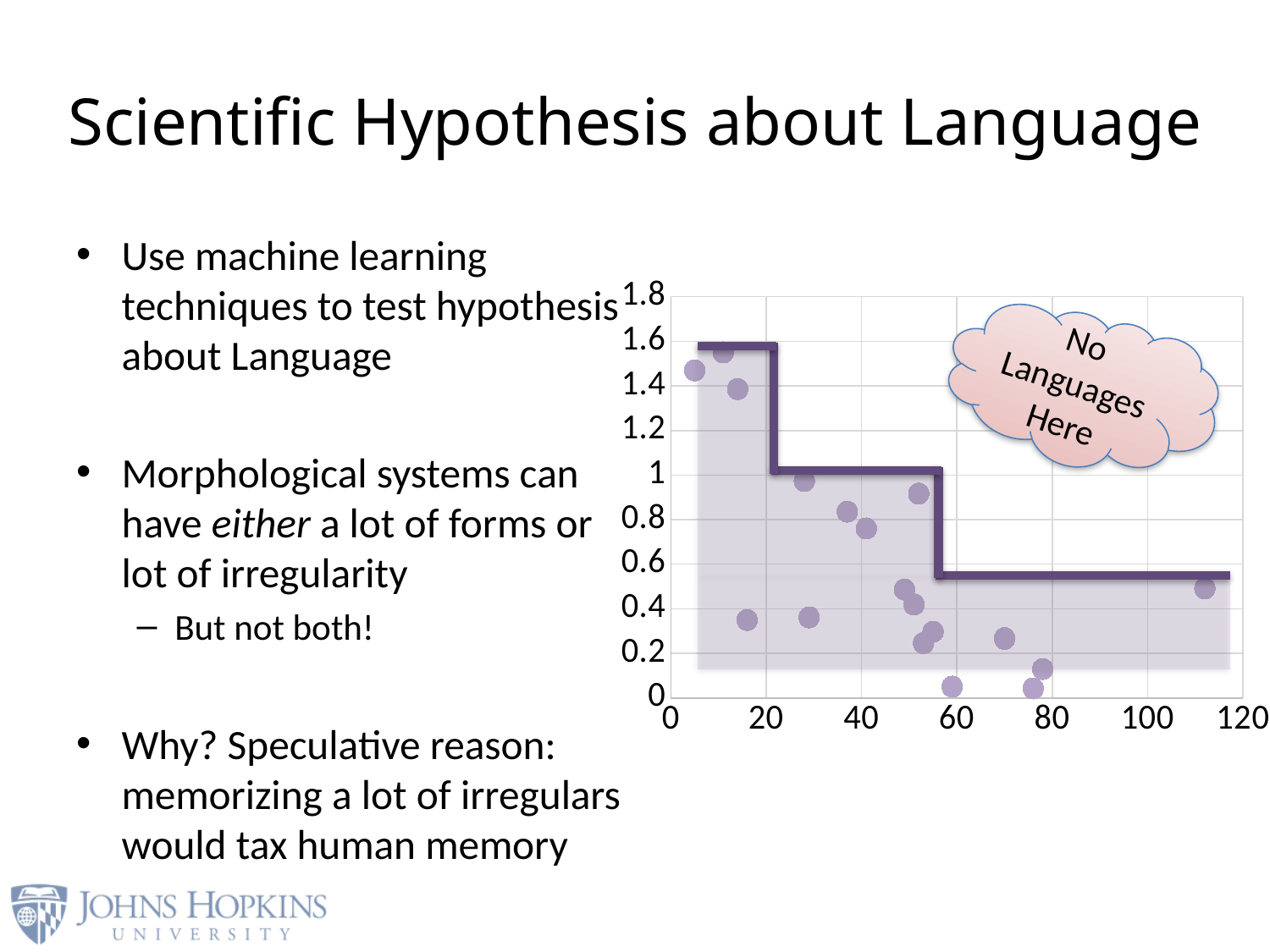
Does the thick step line in the chart rise or fall as x increases? fall What is the highest value shown on the y axis of the chart? 1.8 Is the y value of the lowest point in the chart greater or less than 0.2? less Is the y value of the highest point in the chart greater or less than 1.4? greater What kind of chart is shown on the slide? scatter chart Do the points with x values below 20 have higher or lower y values than the points with x values above 60? higher What is the highest value shown on the x axis of the chart? 120 Is the y value of the rightmost point in the chart greater or less than 1? less